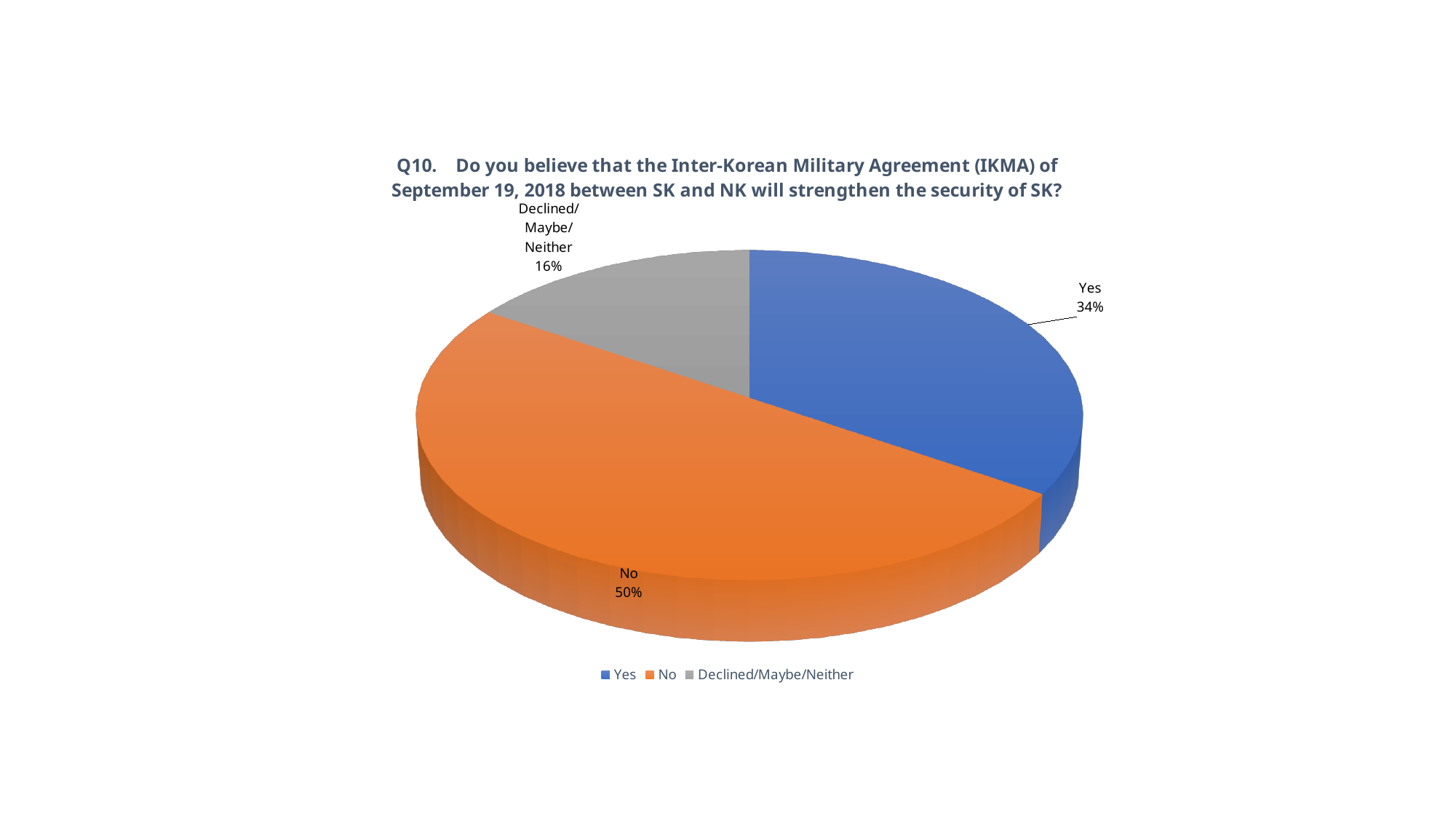
What colour is the "No" slice of the pie? Orange Which is larger, the share for "Yes" or the share for "No"? No How many categories are shown in the pie chart? 3 Which response category has the smallest share of the pie? Declined/Maybe/Neither What is the question number shown at the start of the chart title? Q10 What is the difference in percentage points between the "Yes" and "Declined/Maybe/Neither" shares? 18 Which response category has the largest share of the pie? No What percentage of respondents are in the "Declined/Maybe/Neither" category? 16% What percentage of respondents answered "Yes"? 34% What type of chart is shown on the slide? Pie chart What is the difference in percentage points between the "No" and "Yes" shares? 16 What percentage of respondents answered "No"? 50%